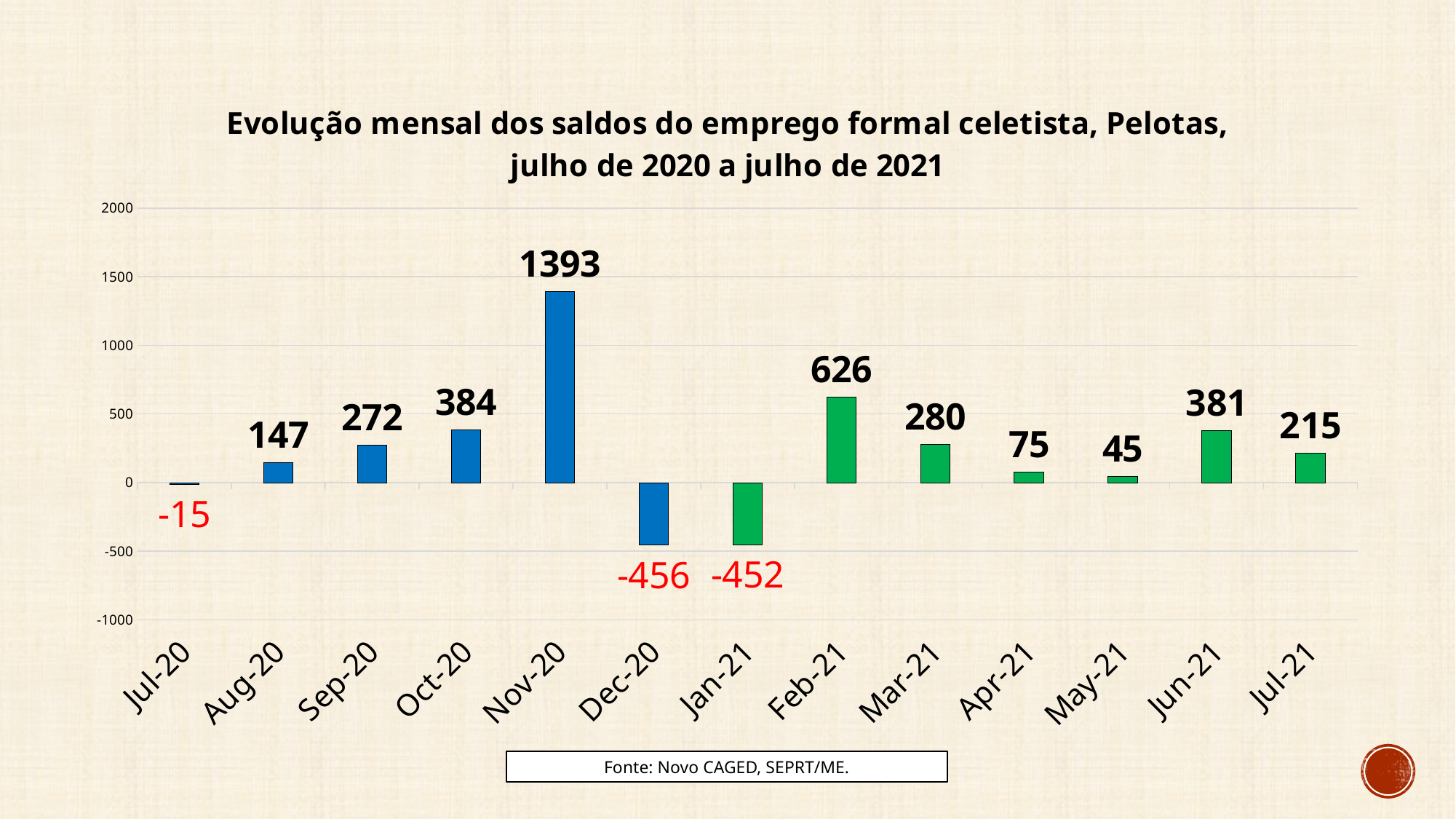
What is the value for May-21? 45 What is the difference between the values for Jun-21 and Jul-21? 166 Is the value for Oct-20 greater or less than 500? less What is the title of the chart? Evolução mensal dos saldos do emprego formal celetista, Pelotas, julho de 2020 a julho de 2021 What kind of chart is shown on the slide? bar chart Which month has the highest value? Nov-20 What is the value for Feb-21? 626 What is the value for Nov-20? 1393 Which is larger, the value for Sep-20 or the value for Mar-21? Mar-21 How many months are shown on the x axis? 13 What is the value for Dec-20? -456 Which month has the lowest value? Dec-20